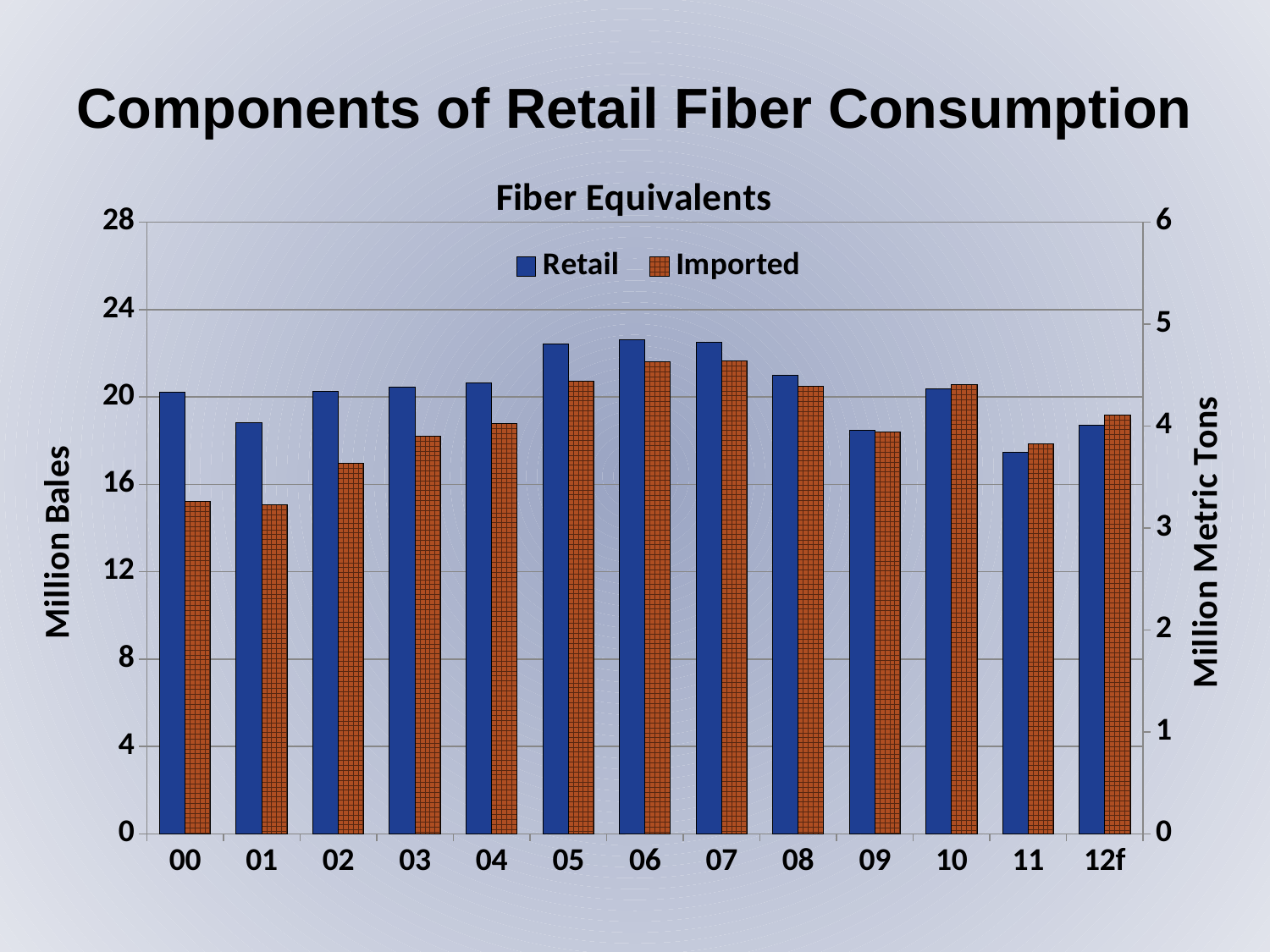
Do the Imported values rise or fall from 00 to 06? rise Is the Imported value for 00 greater or less than 16 million bales? less Is the Imported value for 02 greater or less than 16 million bales? greater Which year has the lowest Retail value? 11 In 00, which is larger, Retail or Imported? Retail Is the Retail value for 05 greater or less than 20 million bales? greater What is the label of the left vertical axis? Million Bales How many series does the legend list? 2 What is the label of the right vertical axis? Million Metric Tons How many year categories are shown on the x axis? 13 What kind of chart is shown on the slide? bar chart